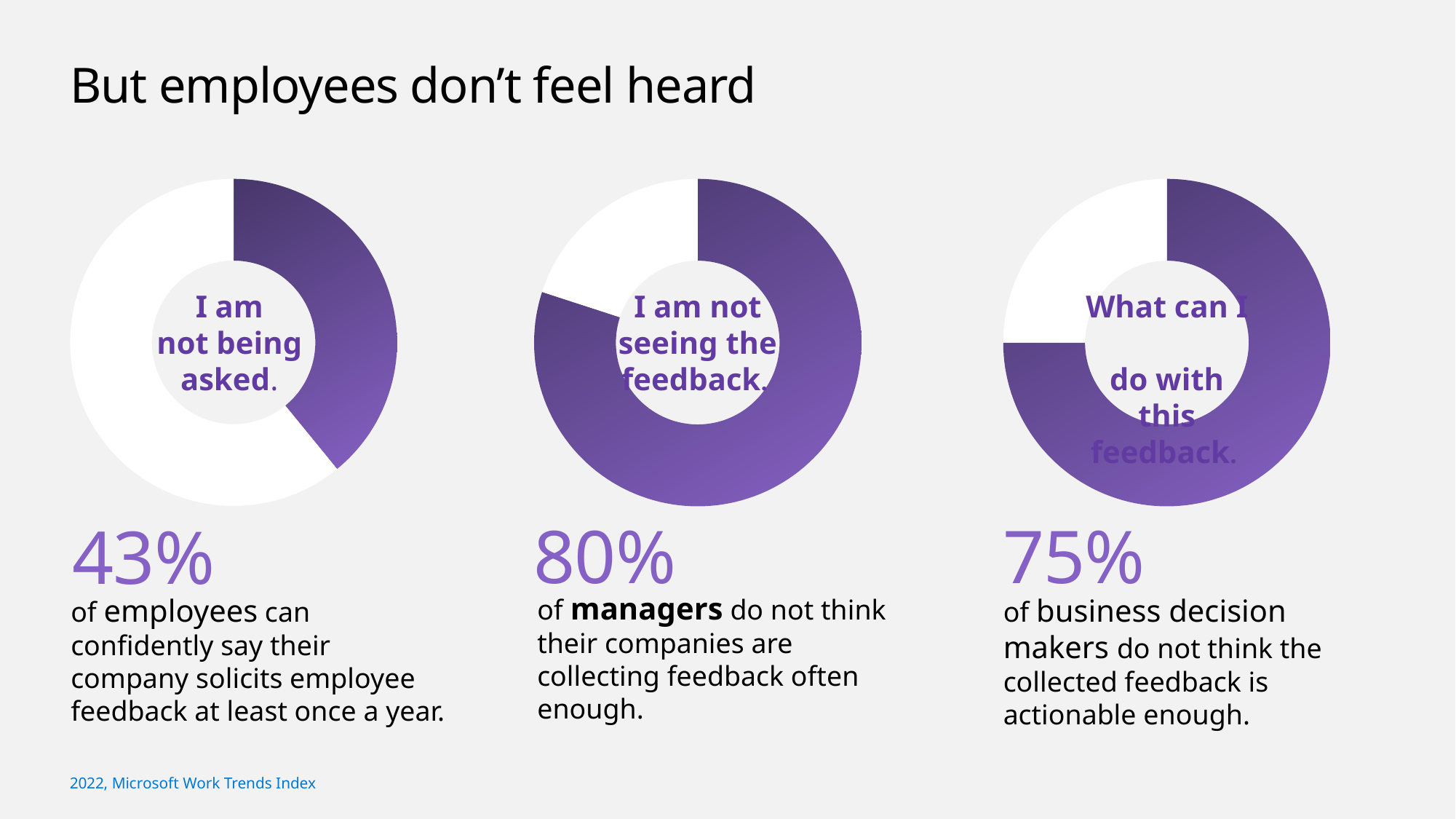
Which of the three donut charts shows the lowest percentage? I am not being asked (43%) What kind of chart is used to show the three percentages on the slide? Donut (pie) chart How many donut charts are on the slide? 3 Which is larger: the percentage for business decision makers in the right chart or the percentage for employees in the left chart? Business decision makers (75%) What is the title of the slide? But employees don't feel heard What percentage is shown for the left donut chart labelled "I am not being asked"? 43% Which of the three donut charts shows the highest percentage? I am not seeing the feedback (80%) What is the difference between the percentage in the middle chart (80%) and the right chart (75%)? 5 percentage points What percentage is shown for the middle donut chart labelled "I am not seeing the feedback"? 80% What percentage is shown for the right donut chart labelled "What can I do with this feedback"? 75% What is the difference between the percentage in the middle chart (managers) and the left chart (employees)? 37 percentage points